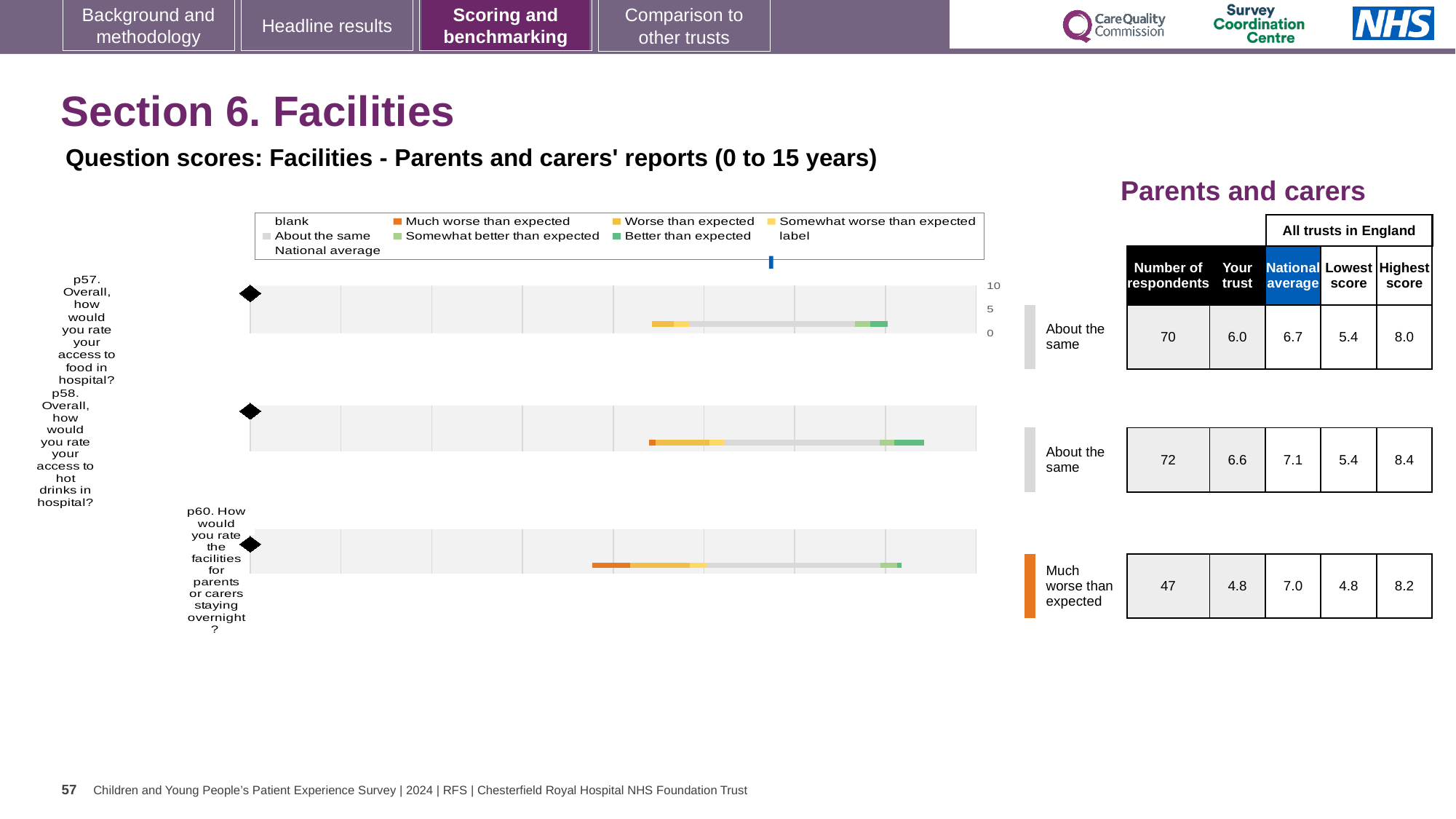
What is the 'Your trust' score for p57 (access to food in hospital)? 6.0 How many survey questions are plotted as separate bars on this slide? 3 What benchmark category is given for p60 (facilities for parents or carers staying overnight)? Much worse than expected What is the lowest score among all trusts in England for p57 (access to food)? 5.4 Which has the higher 'Your trust' score, p57 (access to food) or p58 (access to hot drinks)? p58 (access to hot drinks) Which question has the lowest 'Your trust' score? p60. How would you rate the facilities for parents or carers staying overnight? What kind of chart is used to show the benchmarking bands for each question? Bar chart How many respondents answered p60 (facilities for parents or carers staying overnight)? 47 Which question has the highest national average score? p58. Overall, how would you rate your access to hot drinks in hospital? What is the highest score among all trusts in England for p58 (access to hot drinks)? 8.4 What is the difference between the national average and the 'Your trust' score for p60? 2.2 What is the national average score for p58 (access to hot drinks in hospital)? 7.1